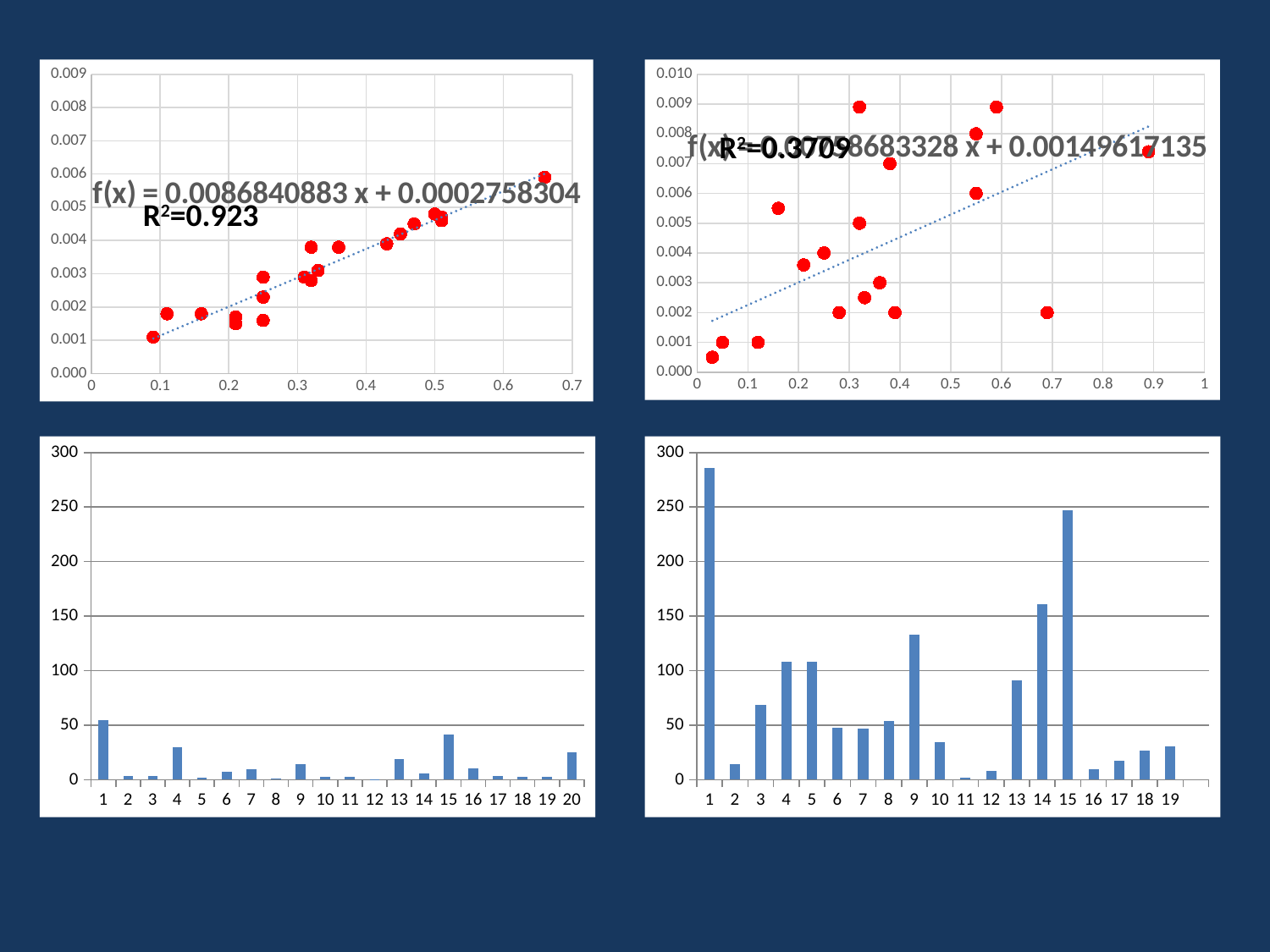
How many categories are shown on the x axis of the bottom-left bar chart? 20 In the bottom-right bar chart, is the value for category 1 greater or less than 250? greater In the bottom-left bar chart, which category has the highest bar? 1 In the bottom-right bar chart, which category has the highest bar? 1 In the bottom-right bar chart, which is larger, the value for category 9 or the value for category 13? category 9 What kind of chart is the top-left chart on the slide? scatter chart In the top-left scatter chart, what R² value is shown? R²=0.923 What kind of chart is the bottom-right chart on the slide? bar chart How many categories are shown on the x axis of the bottom-right bar chart? 19 In the bottom-right bar chart, is the value for category 14 greater or less than 150? greater In the bottom-right bar chart, which category has the lowest bar? 11 In the top-right scatter chart, what R² value is shown? R²=0.3709